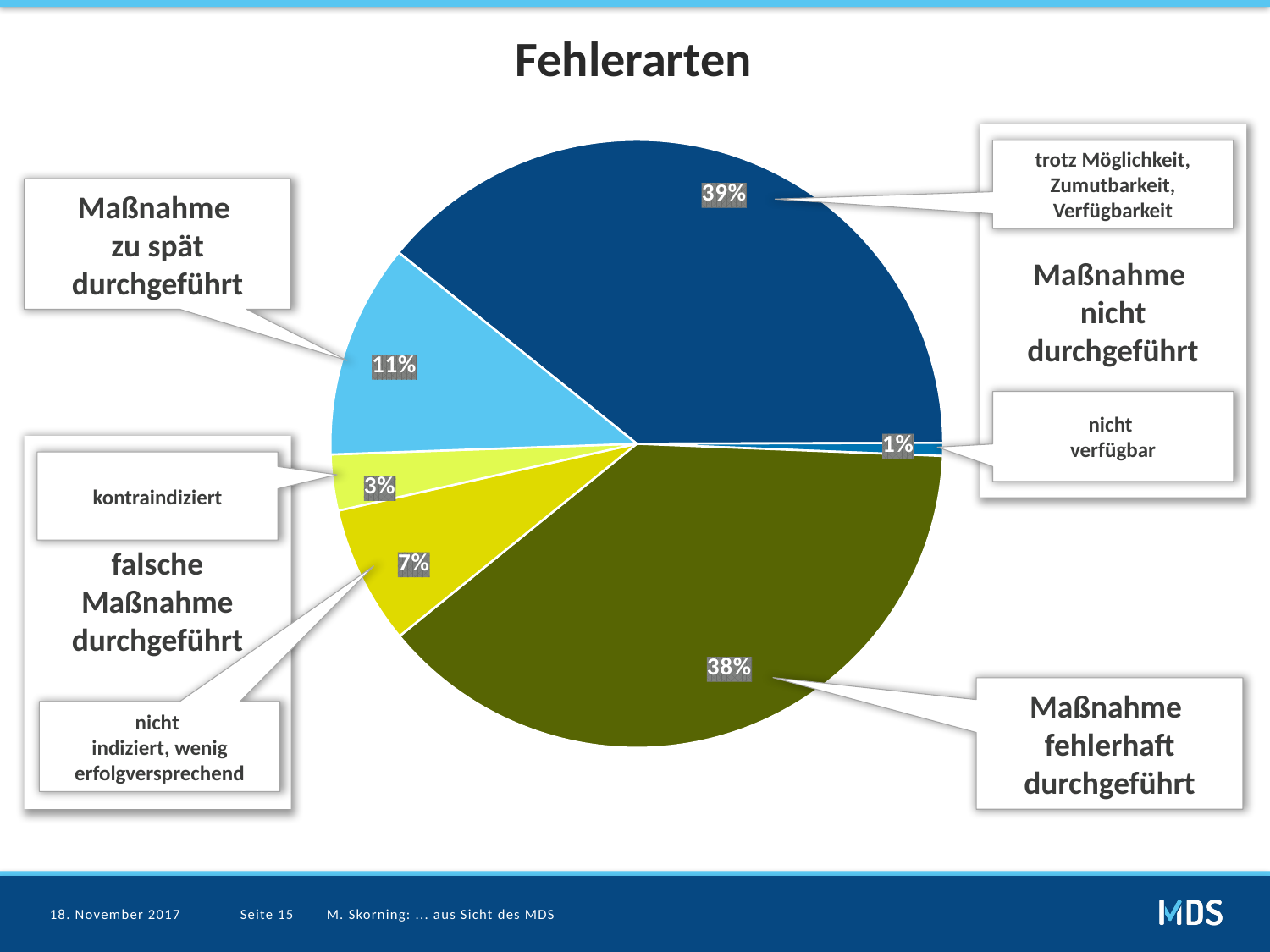
How many slices does the pie chart have? 6 What share of the pie is labelled "kontraindiziert"? 3% Which slice of the pie is the largest? trotz Möglichkeit, Zumutbarkeit, Verfügbarkeit (39%) What kind of chart is shown on the slide? pie chart Which is larger: the slice for "Maßnahme zu spät durchgeführt" or the slice for "kontraindiziert"? Maßnahme zu spät durchgeführt What share of the pie is labelled "Maßnahme fehlerhaft durchgeführt"? 38% What is the title of the chart? Fehlerarten What share of the pie is labelled "nicht indiziert, wenig erfolgversprechend"? 7% What share of the pie is labelled "Maßnahme zu spät durchgeführt"? 11% Which slice of the pie is the smallest? nicht verfügbar (1%) What share of the pie is labelled "nicht verfügbar"? 1% What is the difference between the 39% slice and the 38% slice? 1%